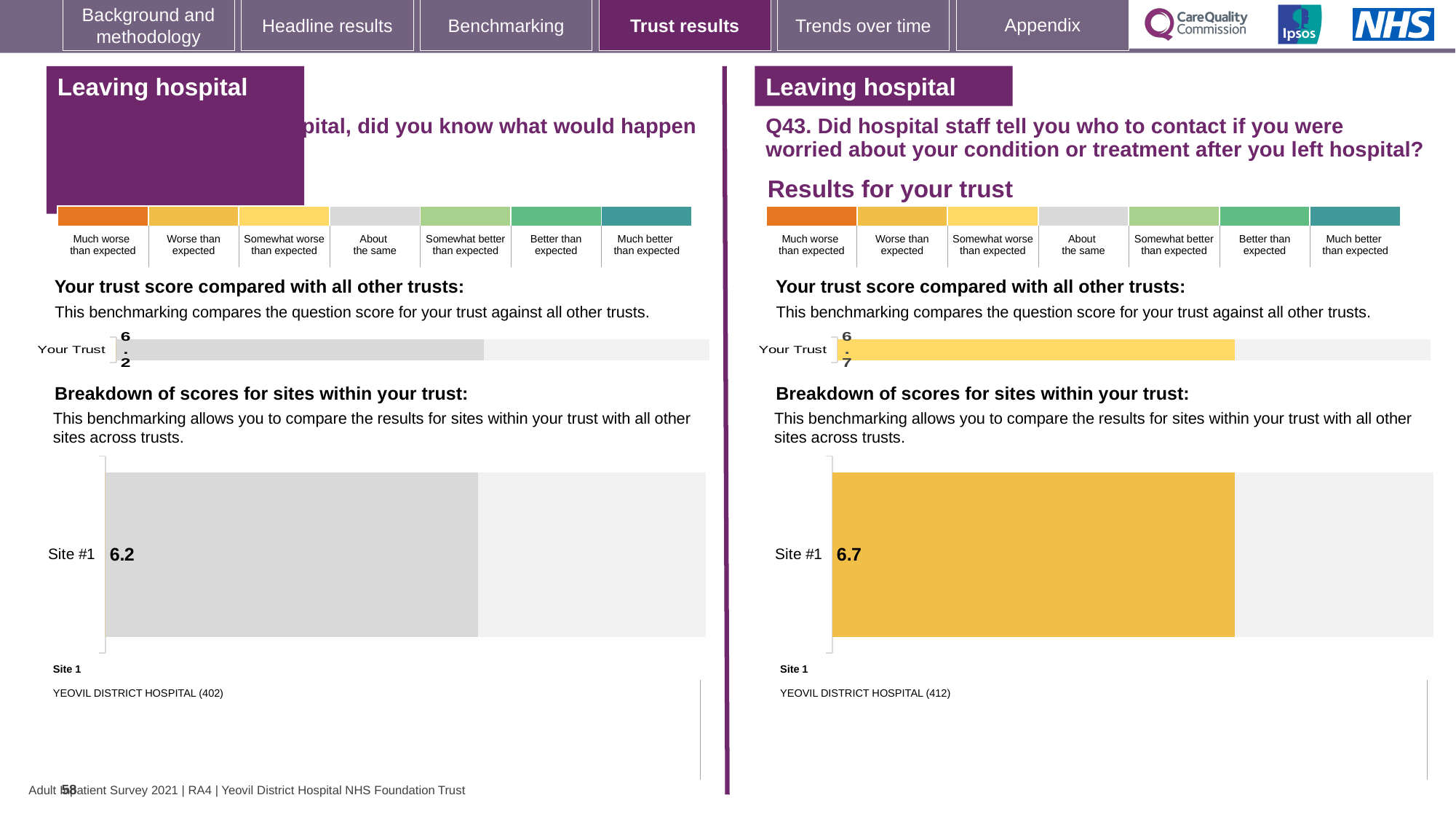
In the right-hand (Q43) breakdown of scores for sites within your trust, what is the score for Site #1? 6.7 What is the difference between the Site #1 score on the right-hand (Q43) chart and the Site #1 score on the left-hand chart? 0.5 On the right-hand (Q43) chart, what is the score shown for Your Trust? 6.7 What kind of chart is used to show the Site #1 score on the right-hand (Q43) side? Bar chart Which site name is listed as Site 1 under the right-hand (Q43) chart? YEOVIL DISTRICT HOSPITAL (412) On the left-hand chart, what is the score shown for Your Trust? 6.2 How many sites are shown in the left-hand breakdown of scores for sites within your trust? 1 What colour is the Site #1 bar on the left-hand chart? Grey What colour is the Site #1 bar on the right-hand (Q43) chart? Yellow Which is larger: the Your Trust score on the left-hand chart or the Your Trust score on the right-hand (Q43) chart? The right-hand (Q43) chart In the left-hand breakdown of scores for sites within your trust, what is the score for Site #1? 6.2 How many sites are shown in the right-hand (Q43) breakdown of scores for sites within your trust? 1